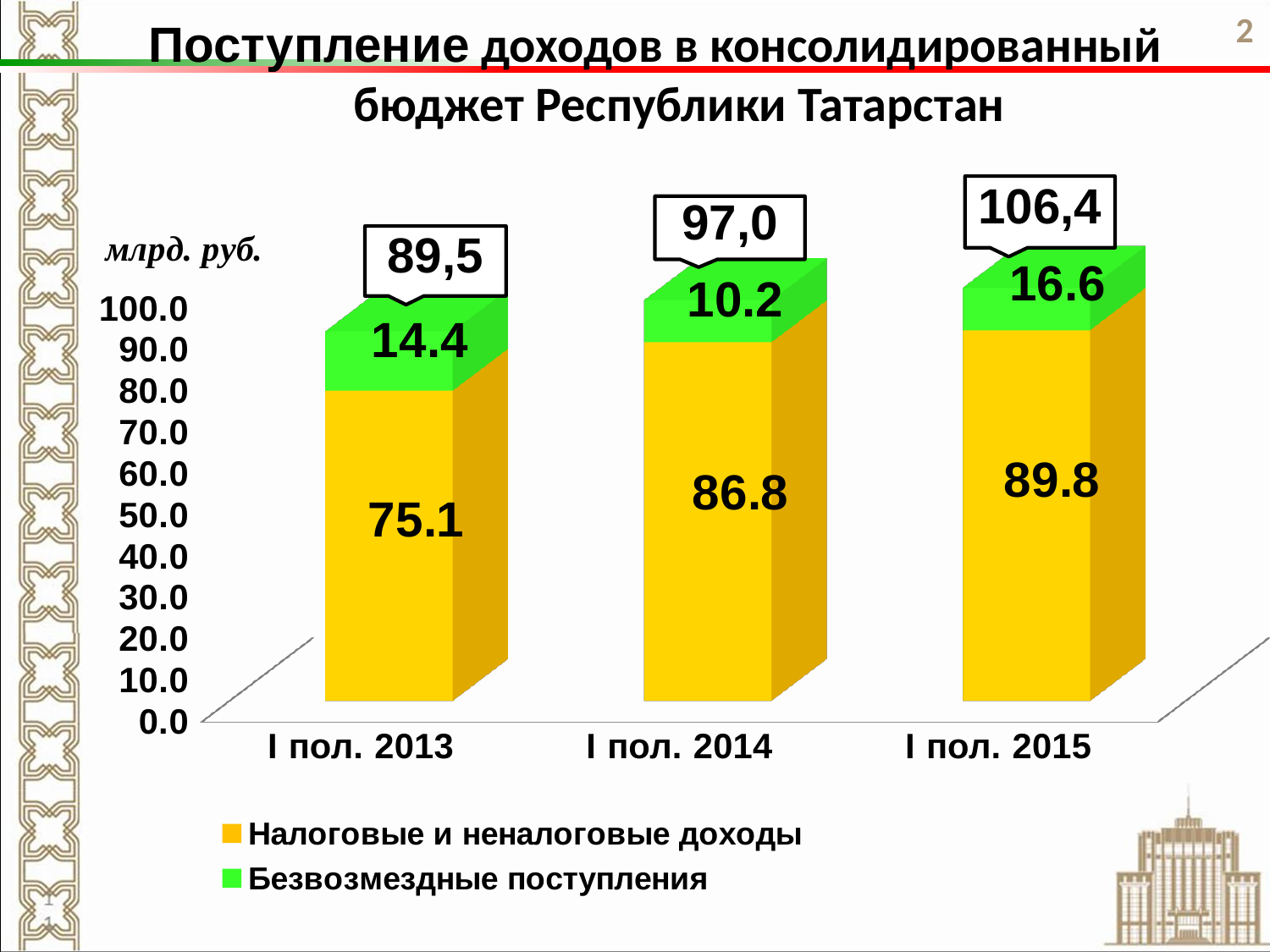
Which period has the highest value of Налоговые и неналоговые доходы? I пол. 2015 Which period has the lowest value of Безвозмездные поступления? I пол. 2014 What kind of chart is shown on the slide? Stacked bar chart What is the value of Безвозмездные поступления for I пол. 2014? 10.2 What is the value of Безвозмездные поступления for I пол. 2015? 16.6 What is the total shown above the bar for I пол. 2015? 106,4 Which is larger: Безвозмездные поступления in I пол. 2013 or in I пол. 2015? I пол. 2015 How many periods are shown on the x axis? 3 How many series does the legend list? 2 What is the total shown above the bar for I пол. 2013? 89,5 What is the value of Налоговые и неналоговые доходы for I пол. 2013? 75.1 What is the difference between Налоговые и неналоговые доходы in I пол. 2014 and I пол. 2013? 11.7